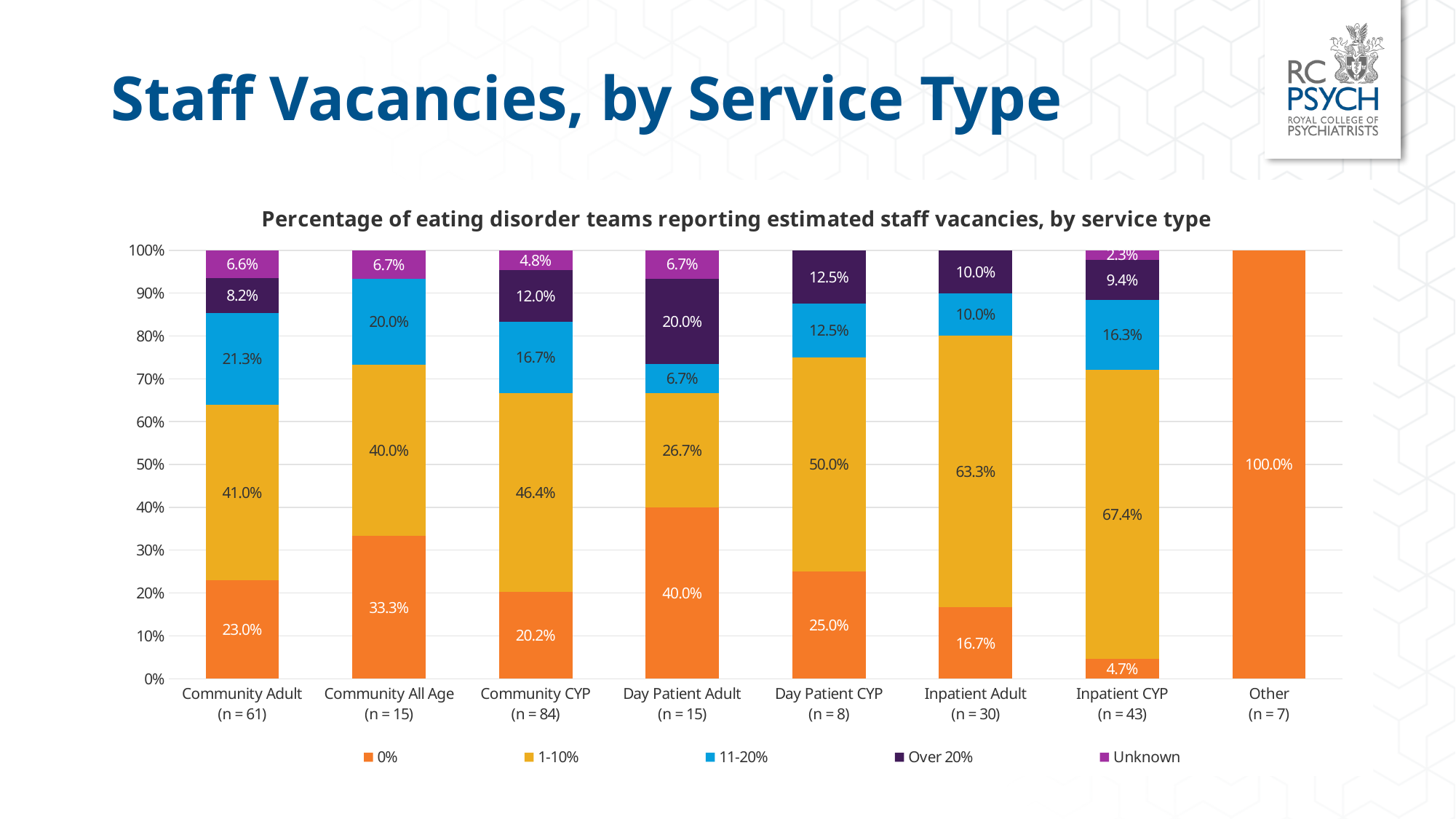
What is the sample size (n) shown for Community CYP? 84 Which is larger: the 11-20% value for Community Adult or for Community All Age? Community Adult Which service type has the highest value for the 1-10% series? Inpatient CYP What is the value of the Over 20% segment for Day Patient Adult? 20.0% What is the value of the Unknown segment for Inpatient CYP? 2.3% How many service type categories are shown on the x axis? 8 What percentage of Community Adult teams reported 0% staff vacancies? 23.0% Excluding Other, which service type has the lowest value for the 0% series? Inpatient CYP What kind of chart is shown on the slide? Stacked bar chart What percentage of Inpatient Adult teams reported 1-10% staff vacancies? 63.3% How many series does the legend list? 5 What is the difference between the 0% values for Day Patient Adult and Community CYP? 19.8%